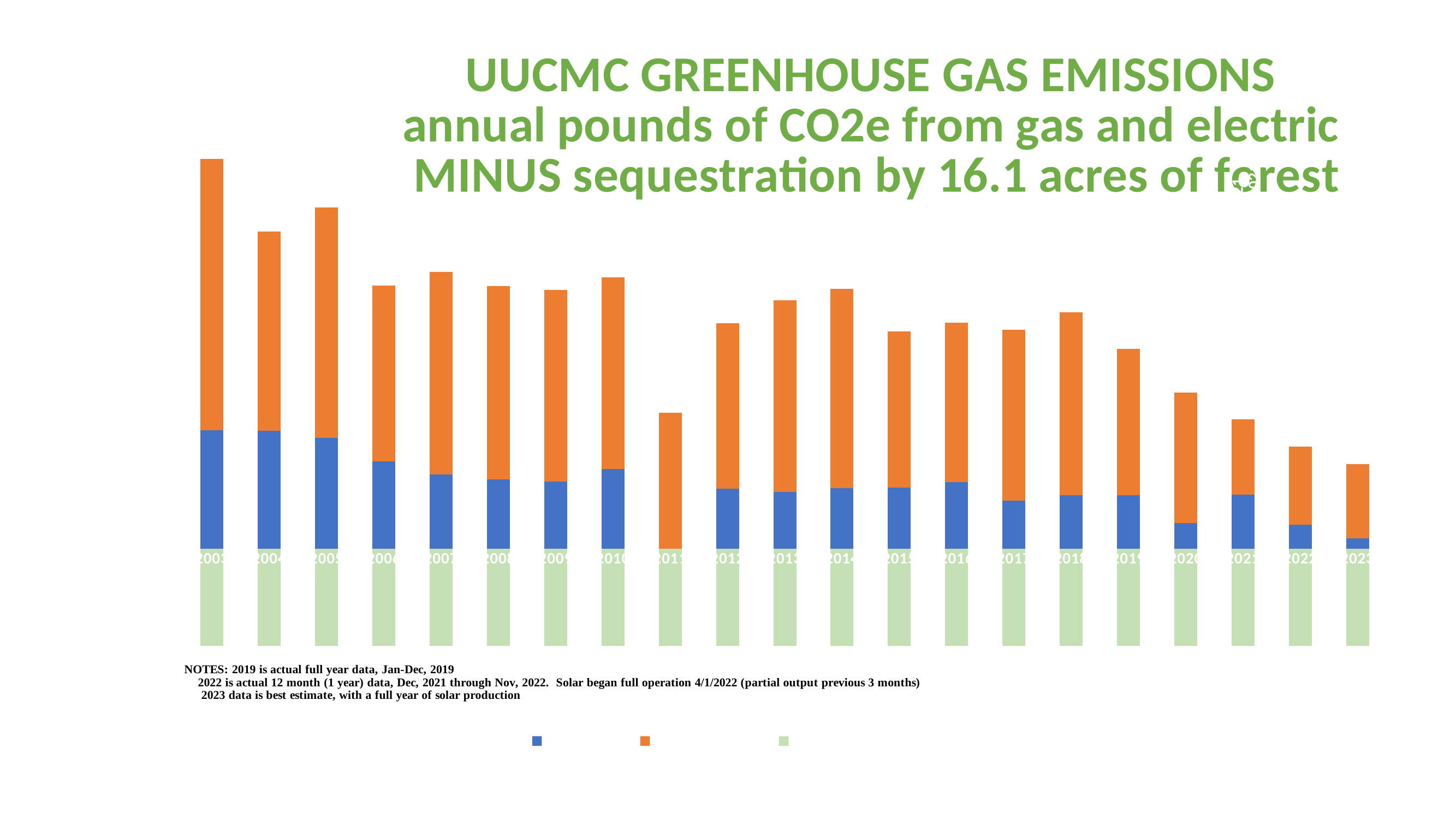
According to the chart title, how many acres of forest provide the sequestration? 16.1 acres Which year has the tallest bar above the axis? 2003 Do the bars above the axis generally rise or fall from 2003 to 2023? Fall What kind of chart is shown on the slide? Stacked bar chart What is the first line of the chart title? UUCMC GREENHOUSE GAS EMISSIONS Which year has a taller bar above the axis, 2003 or 2023? 2003 How many years are plotted along the x axis? 21 How many series does the legend list? 3 Which year has a taller bar above the axis, 2011 or 2012? 2012 Which year has a taller bar above the axis, 2019 or 2020? 2019 Which year has the shortest bar above the axis? 2023